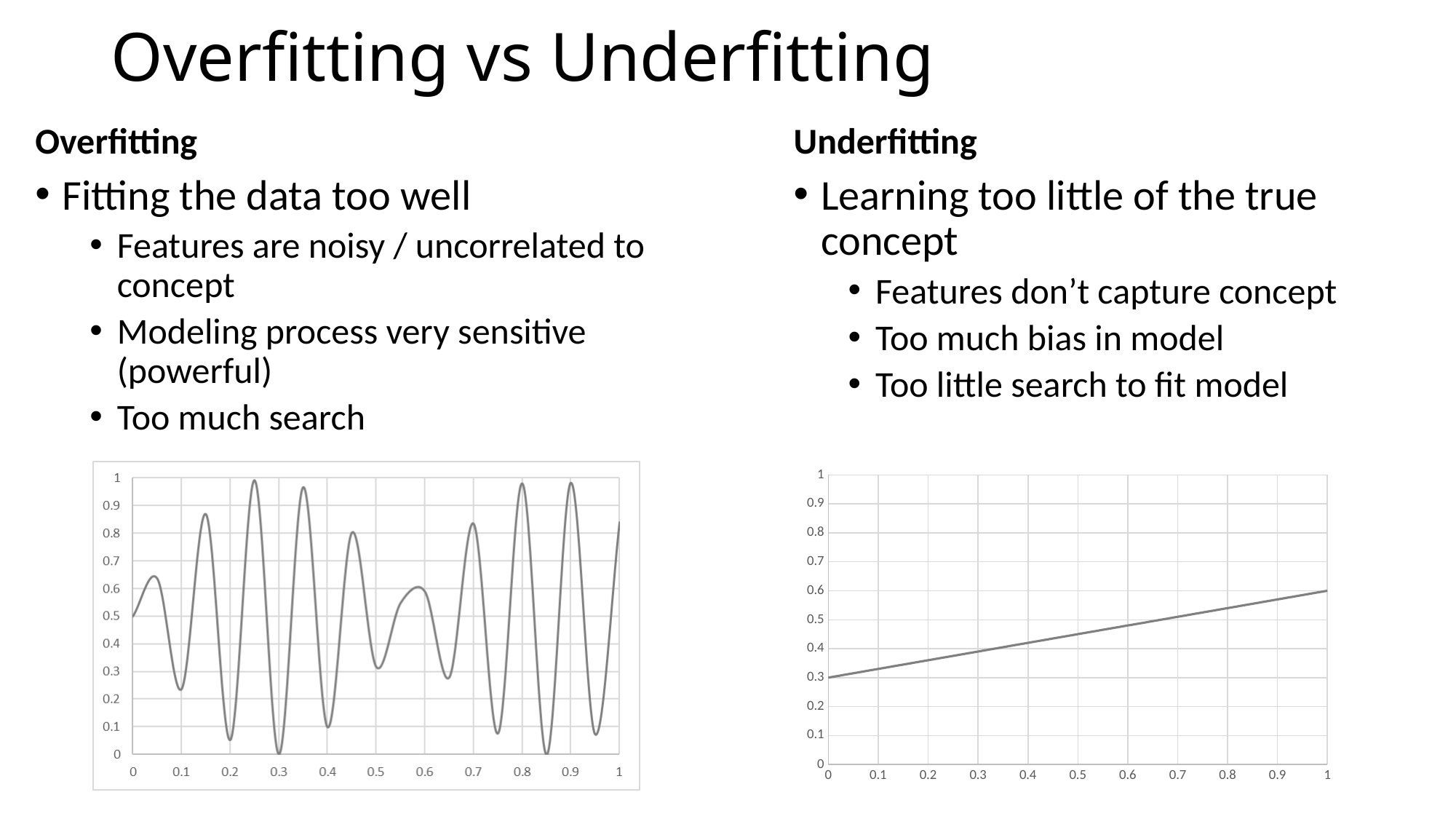
In the Overfitting chart on the left, what is the value of the line at x = 0? 0.5 In the Underfitting chart on the right, does the line rise or fall as x increases from 0 to 1? rises In the Overfitting chart on the left, is the value at x = 0.25 greater or less than 0.9? greater In the Overfitting chart on the left, is the value at x = 0.2 greater or less than 0.1? less In the Underfitting chart on the right, is the value at x = 0.9 greater or less than 0.5? greater In the Underfitting chart on the right, is the value at x = 0 or at x = 1 larger? x = 1 What kind of chart is shown under the Overfitting heading on the left? line chart In the Underfitting chart on the right, what is the value of the line at x = 1? 0.6 In the Underfitting chart on the right, what is the value of the line at x = 0? 0.3 In the Underfitting chart on the right, what is the difference between the line's value at x = 1 and at x = 0? 0.3 What is the highest value shown on the y axis of the Underfitting chart on the right? 1 What kind of chart is shown under the Underfitting heading on the right? line chart